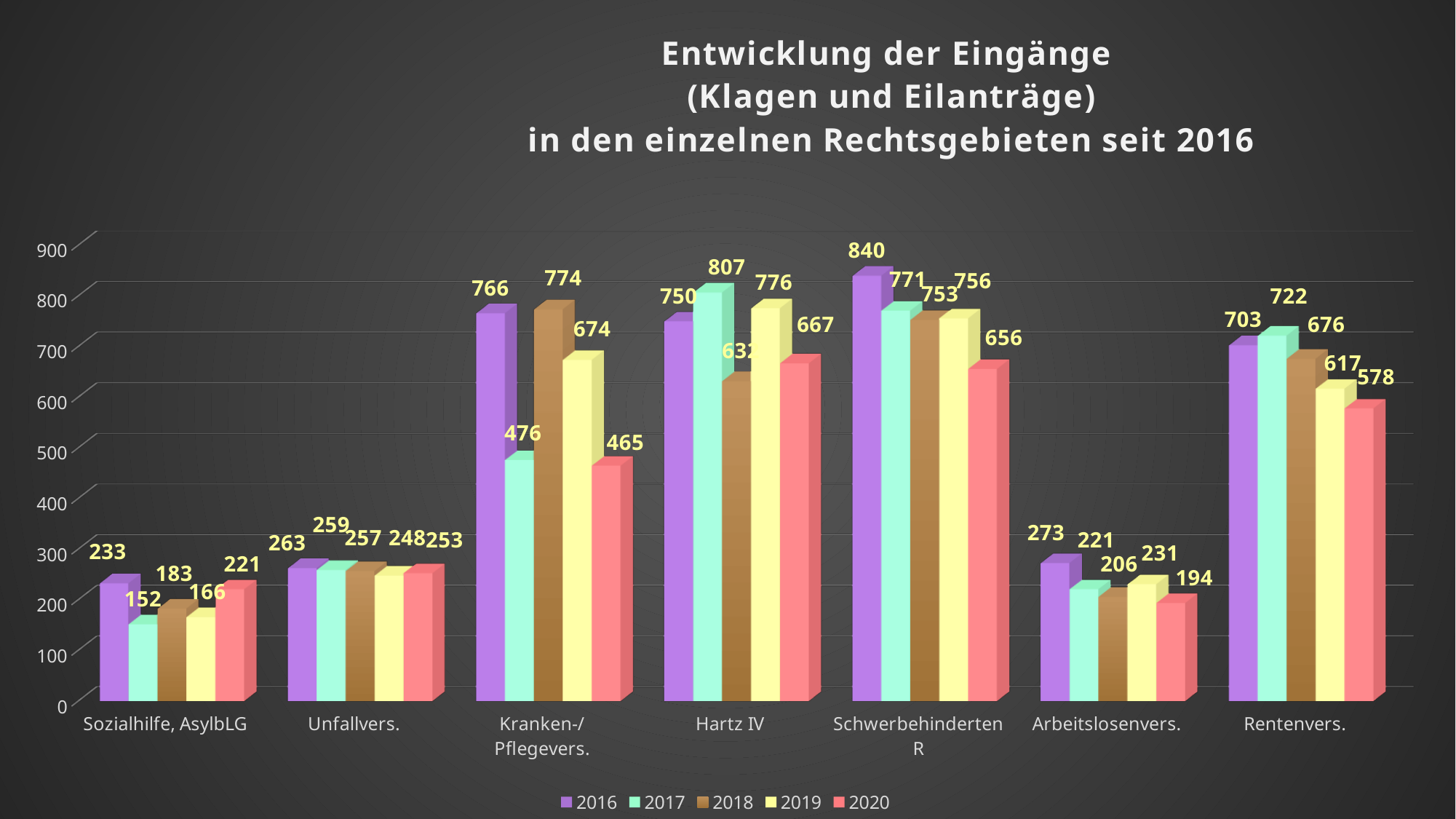
Which category has the lowest value in 2017? Sozialhilfe, AsylbLG What is the value for Kranken-/Pflegevers. in 2018? 774 What kind of chart is shown on the slide? bar chart Is the 2018 value for Rentenvers. greater or less than 600? greater Which category has the highest value in 2016? SchwerbehindertenR How many categories are shown on the x axis? 7 How many series does the legend list? 5 What is the difference between the 2016 and 2020 values for Kranken-/Pflegevers.? 301 What is the value for Rentenvers. in 2020? 578 What is the value for Hartz IV in 2017? 807 Which is larger: the 2019 value for Hartz IV or the 2019 value for SchwerbehindertenR? Hartz IV Do the values for Rentenvers. rise or fall from 2017 to 2020? fall